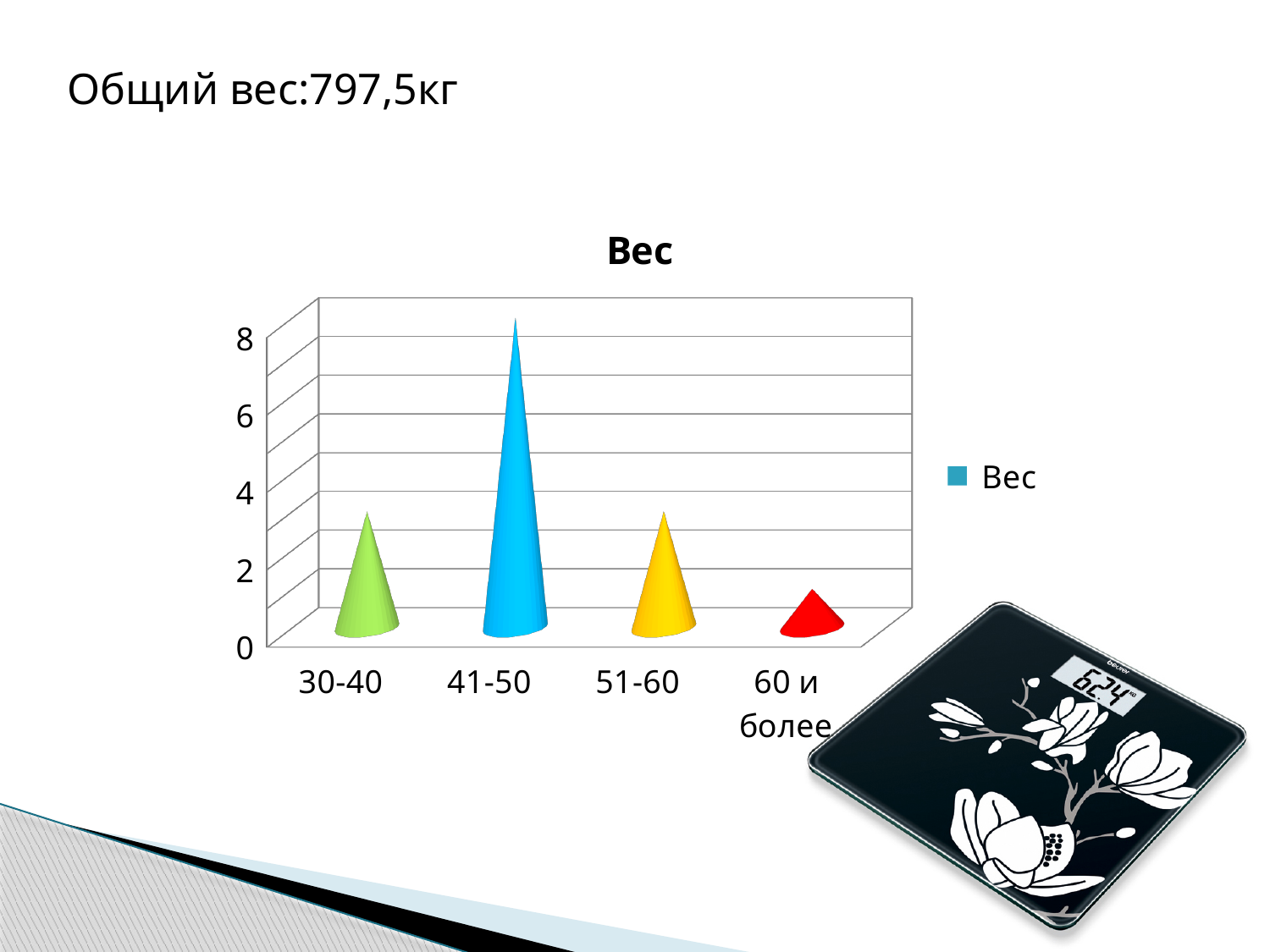
Is the value for 41-50 greater or less than 6? greater Which category has the highest value in the chart? 41-50 What is the title of the chart? Вес What kind of chart is shown on the slide? bar chart Do the values rise or fall from 41-50 to 60 и более along the x axis? fall Which has the larger value, 41-50 or 30-40? 41-50 How many series does the chart's legend list? 1 Which has the larger value, 51-60 or 60 и более? 51-60 How many categories are shown on the x axis of the chart? 4 Which category has the lowest value in the chart? 60 и более Is the value for 60 и более greater or less than 2? less Is the value for 51-60 greater or less than 4? less